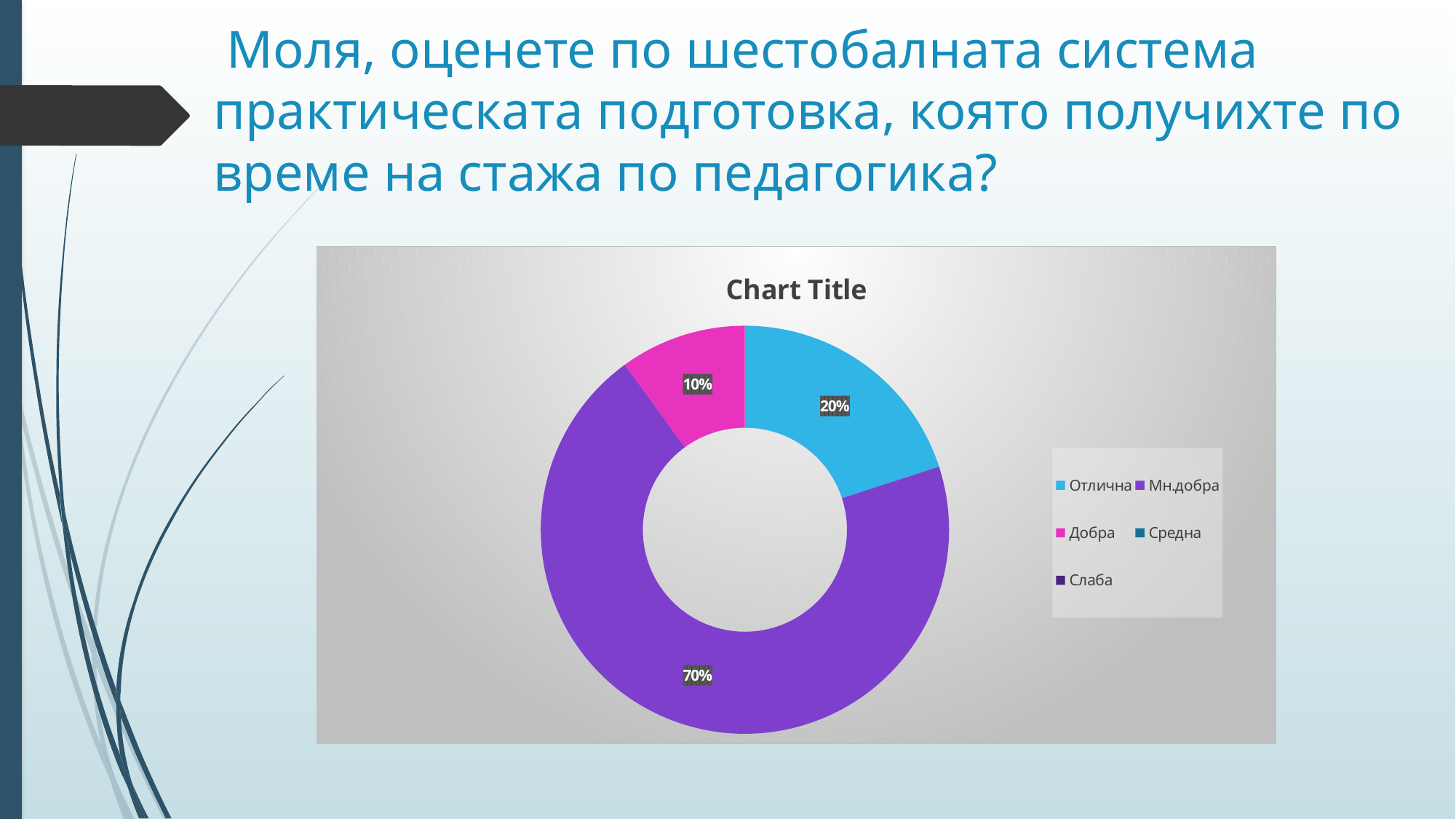
How many categories does the legend list? 5 Which is larger, the share for Отлична or the share for Добра? Отлична What percentage is shown for Мн.добра? 70% What is the difference between the shares of Мн.добра and Отлична? 50% Which category has the largest share of the chart? Мн.добра What percentage is shown for Отлична? 20% What is the title of the chart? Chart Title What percentage is shown for Добра? 10% What is the difference between the shares of Отлична and Добра? 10% How many slices with data labels are visible in the chart? 3 What kind of chart is shown on the slide? doughnut chart Which of the labelled slices has the smallest share? Добра